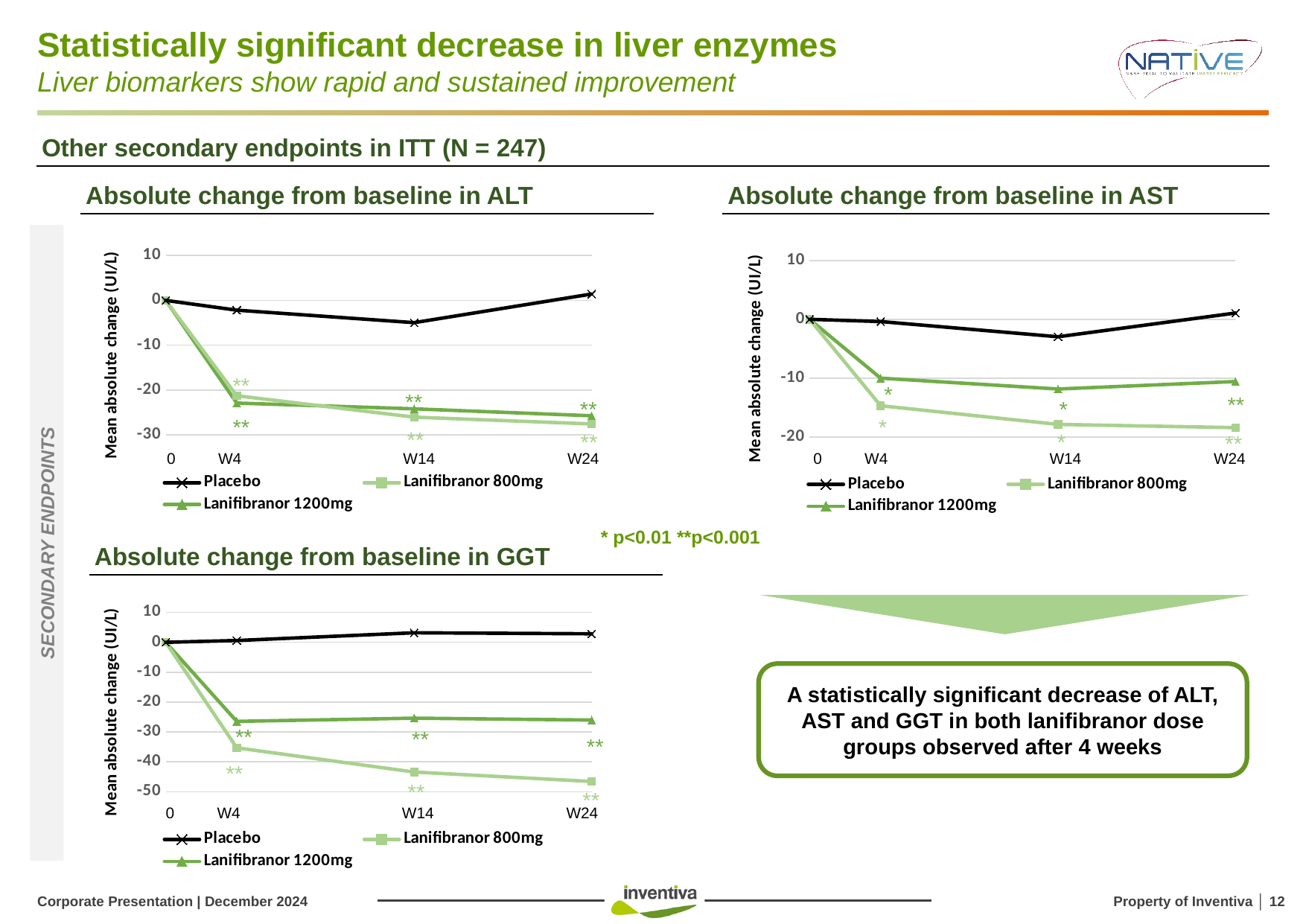
In the 'Absolute change from baseline in ALT' chart, how many series does the legend list? 3 What kind of chart is the 'Absolute change from baseline in ALT' chart? line chart In the 'Absolute change from baseline in ALT' chart, which series has the highest value at W24? Placebo In the 'Absolute change from baseline in GGT' chart, how many time points are plotted along the x axis? 4 In the 'Absolute change from baseline in ALT' chart, is the value for Lanifibranor 800mg at W24 greater or less than -20? less In the 'Absolute change from baseline in AST' chart, is the value for Lanifibranor 1200mg at W24 greater or less than -20? greater In the 'Absolute change from baseline in AST' chart, which series has the lower value at W4, Lanifibranor 800mg or Lanifibranor 1200mg? Lanifibranor 800mg In the 'Absolute change from baseline in GGT' chart, does the Lanifibranor 800mg line rise or fall from 0 to W24? fall In the 'Absolute change from baseline in GGT' chart, is the value for Lanifibranor 800mg at W14 greater or less than -30? less In the 'Absolute change from baseline in GGT' chart, which series has the lower value at W24, Lanifibranor 800mg or Lanifibranor 1200mg? Lanifibranor 800mg What is the y-axis label of the 'Absolute change from baseline in AST' chart? Mean absolute change (UI/L) In the 'Absolute change from baseline in GGT' chart, which series has the lowest value at W24? Lanifibranor 800mg